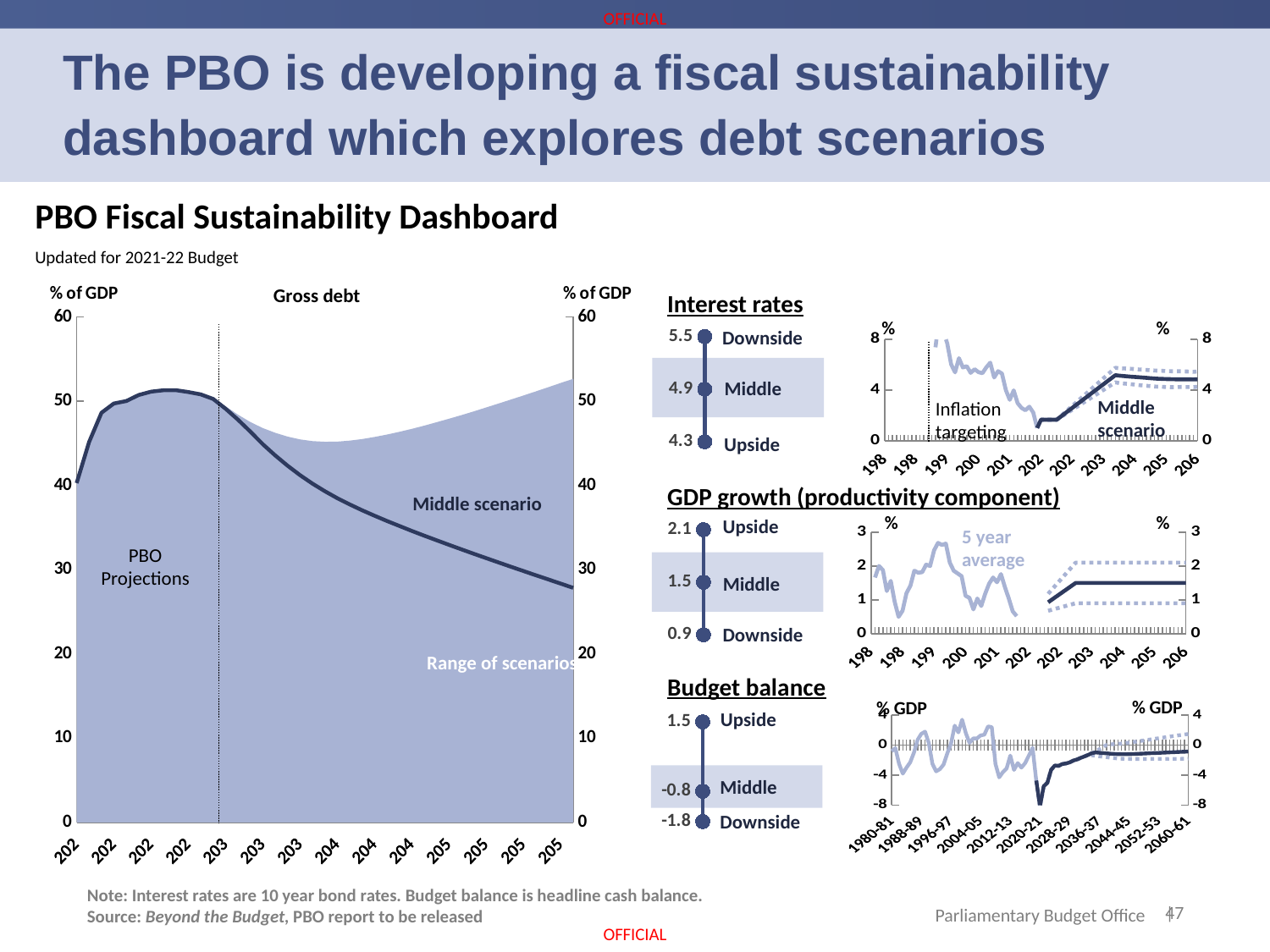
In the Interest rates panel, what is the Downside scenario value? 5.5 On the Gross debt chart, does the Middle scenario line rise or fall after the dotted vertical line marking the end of the PBO Projections? fall In the Budget balance panel, what is the Middle scenario value? -0.8 In the Interest rates panel, what is the Middle scenario value? 4.9 On the Gross debt chart, what unit is shown on the y axis? % of GDP On the Gross debt chart, what does the shaded area to the right of the PBO Projections represent? Range of scenarios On the Gross debt chart, is the Middle scenario value at the far right of the x axis greater or less than 30? less In the Budget balance panel, which is larger, the Upside value or the Downside value? Upside In the GDP growth (productivity component) panel, what is the Upside scenario value? 2.1 In the GDP growth (productivity component) panel, which scenario has the lowest value? Downside In the Interest rates panel, what is the difference between the Downside and Upside values? 1.2 On the Gross debt chart, is the peak of the Middle scenario line greater or less than 40? greater